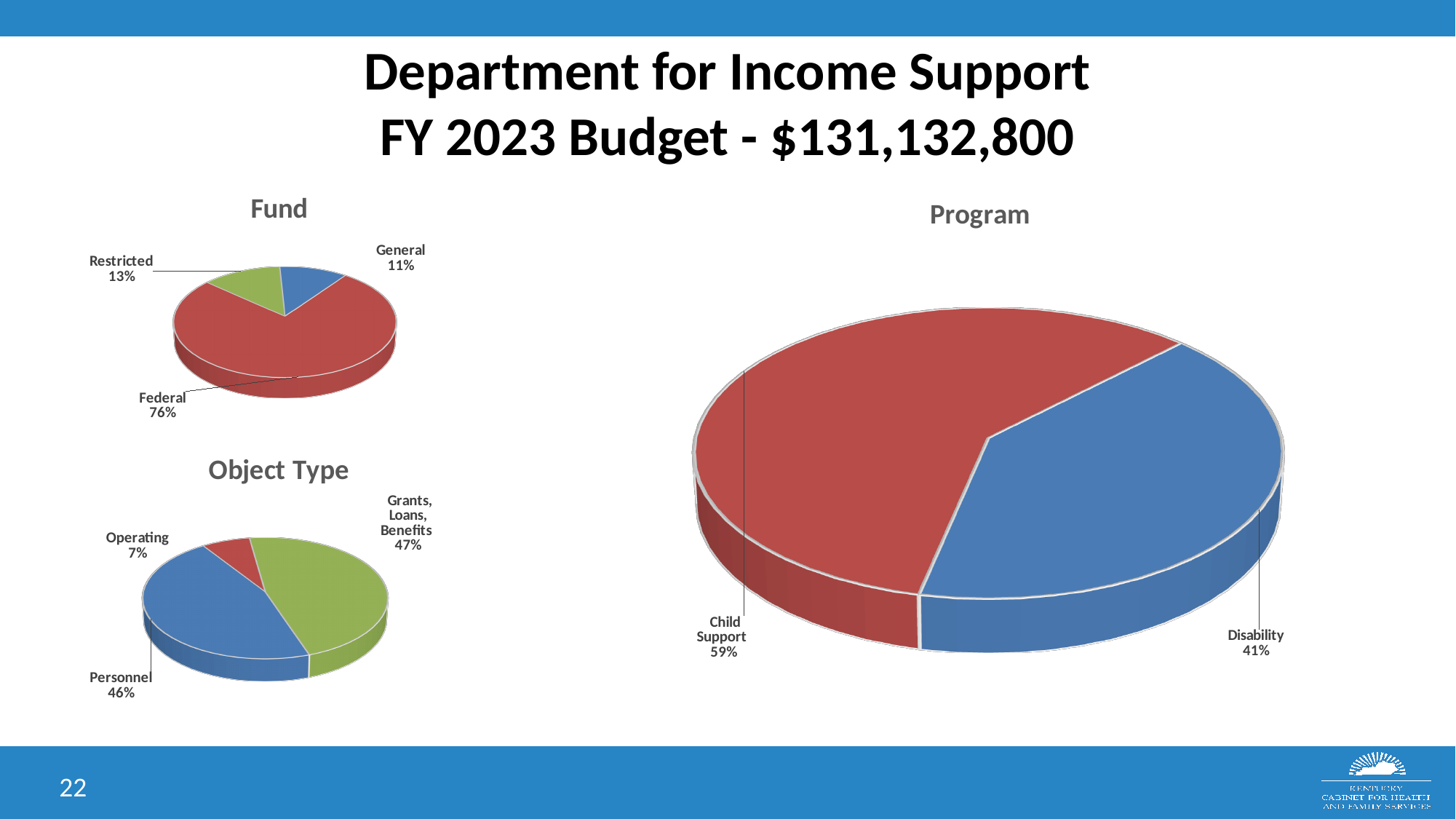
In the Fund chart, what share of the budget is Restricted? 13% In the Program chart, which program has the larger share, Child Support or Disability? Child Support In the Program chart, what is the difference in percentage points between Child Support and Disability? 18 In the Object Type chart, which object type has the largest share? Grants, Loans, Benefits In the Object Type chart, what is the difference in percentage points between Grants, Loans, Benefits and Personnel? 1 In the Fund chart, what share of the budget is Federal? 76% In the Fund chart, which fund source has the smallest share? General In the Object Type chart, what share is Operating? 7% In the Fund chart, how many slices does the pie have? 3 In the Object Type chart, what share is Grants, Loans, Benefits? 47% What kind of chart is the Program chart? Pie chart In the Program chart, what share of the budget is Child Support? 59%